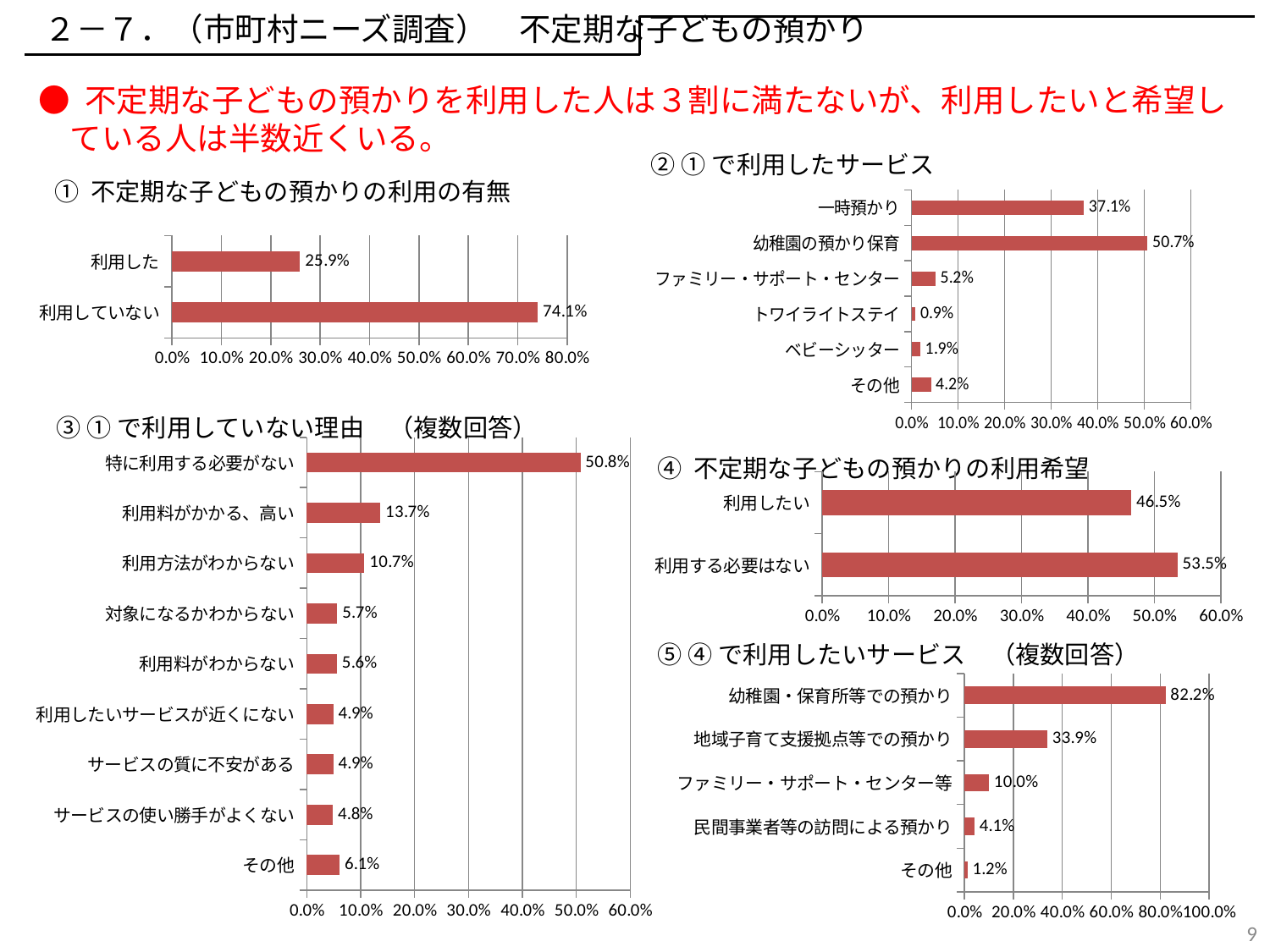
In chart ④ 不定期な子どもの預かりの利用希望, what is the value for 利用したい? 46.5% In chart ① 不定期な子どもの預かりの利用の有無, what is the value for 利用した? 25.9% What type of chart is chart ⑤ ④で利用したいサービス? Bar chart In chart ⑤ ④で利用したいサービス, what is the value for 幼稚園・保育所等での預かり? 82.2% In chart ③ ①で利用していない理由, what is the value for 利用料がかかる、高い? 13.7% In chart ② ①で利用したサービス, what is the value for 一時預かり? 37.1% In chart ② ①で利用したサービス, which category has the highest value? 幼稚園の預かり保育 In chart ② ①で利用したサービス, which category has the lowest value? トワイライトステイ In chart ③ ①で利用していない理由, which is larger, 利用方法がわからない or その他? 利用方法がわからない In chart ① 不定期な子どもの預かりの利用の有無, what is the difference between 利用していない and 利用した? 48.2% In chart ③ ①で利用していない理由, how many categories are shown? 9 In chart ⑤ ④で利用したいサービス, what is the difference between 地域子育て支援拠点等での預かり and ファミリー・サポート・センター等? 23.9%